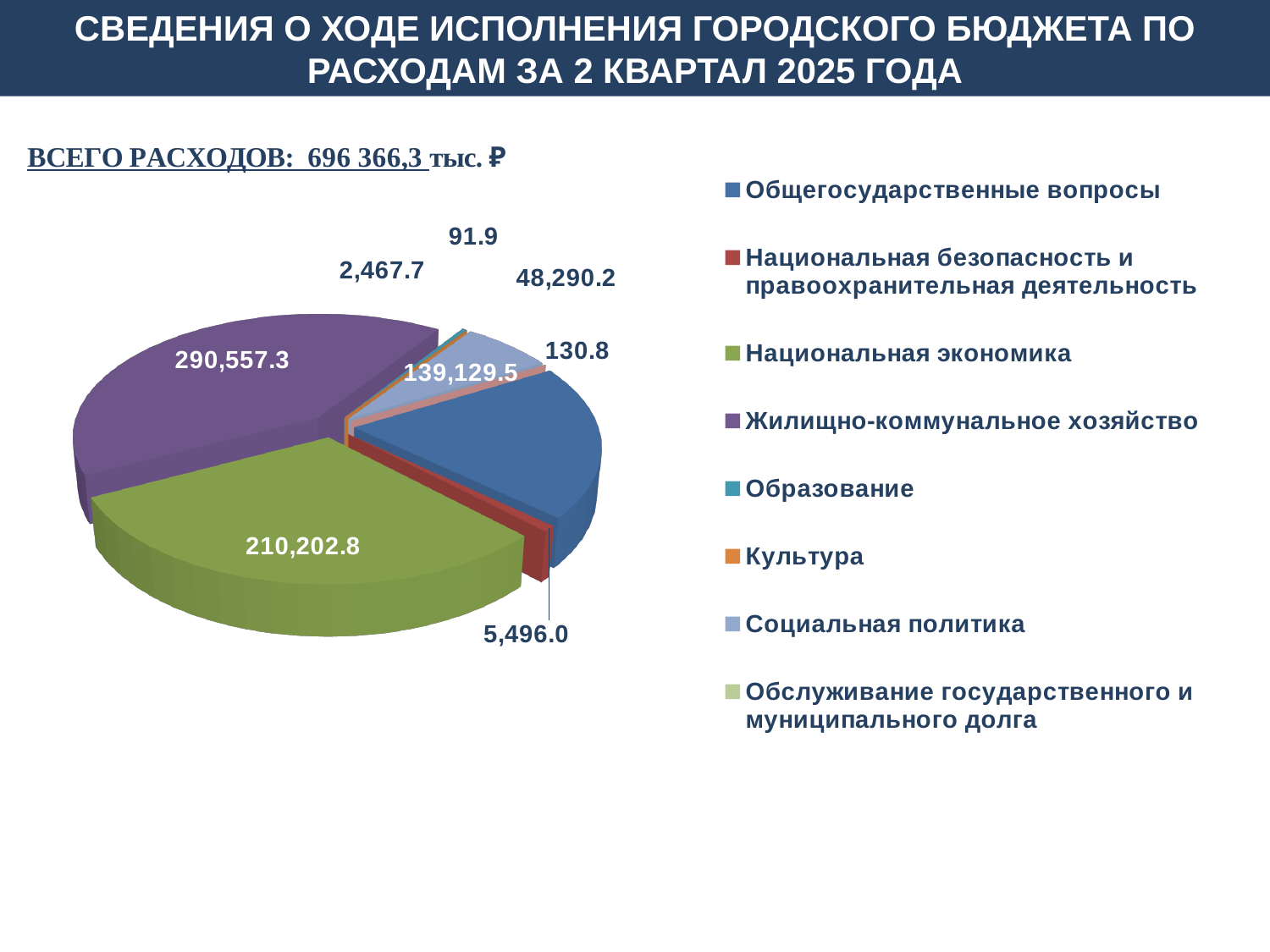
What is the value for Национальная экономика? 210,202.8 What is the value for Жилищно-коммунальное хозяйство? 290,557.3 Which category has the largest slice of the pie? Жилищно-коммунальное хозяйство Which is larger: the value for Национальная экономика or the value for Социальная политика? Национальная экономика What is the difference between the values for Общегосударственные вопросы and Национальная безопасность и правоохранительная деятельность? 133,633.5 How many categories does the legend of the pie chart list? 8 What is the value for Национальная безопасность и правоохранительная деятельность? 5,496.0 What is the value for Общегосударственные вопросы? 139,129.5 What is the difference between the values for Жилищно-коммунальное хозяйство and Национальная экономика? 80,354.5 What kind of chart is shown on the slide? Pie chart What total expenditure (ВСЕГО РАСХОДОВ) is stated on the slide? 696 366,3 тыс. ₽ What is the value for Социальная политика? 48,290.2